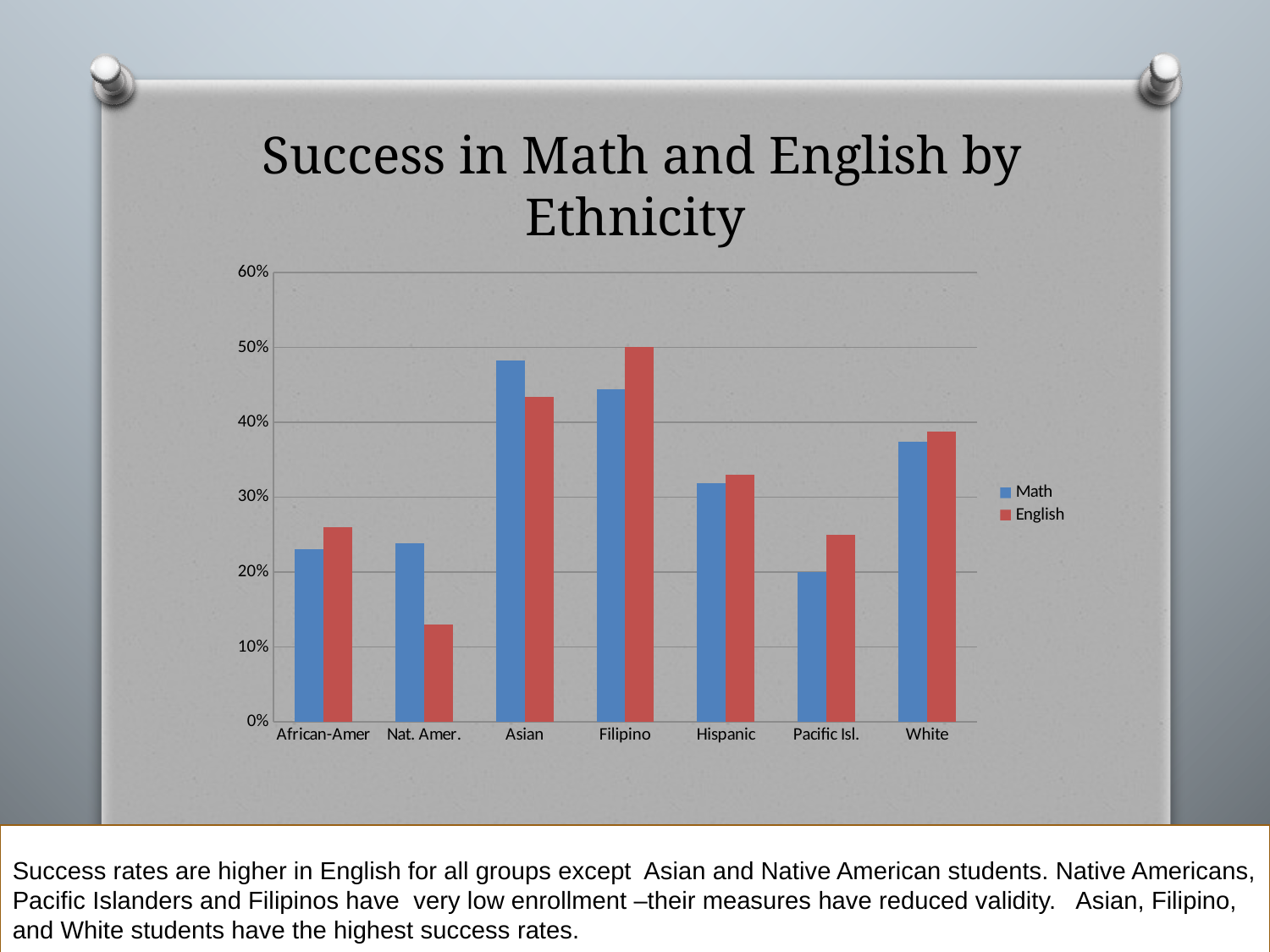
Is the English success rate for Nat. Amer. students greater or less than 20%? less Which group has the highest English success rate? Filipino For Nat. Amer. students, which is higher, the Math or the English success rate? Math Is the Math success rate for Asian students greater or less than 40%? greater Which group has the lowest Math success rate? Pacific Isl. How many ethnic groups are shown on the x axis of the chart? 7 For Asian students, which is higher, the Math or the English success rate? Math How many series does the chart's legend list? 2 What kind of chart is shown on the slide? bar chart Which group has the lowest English success rate? Nat. Amer. Which group has the highest Math success rate? Asian What is the title of the chart? Success in Math and English by Ethnicity